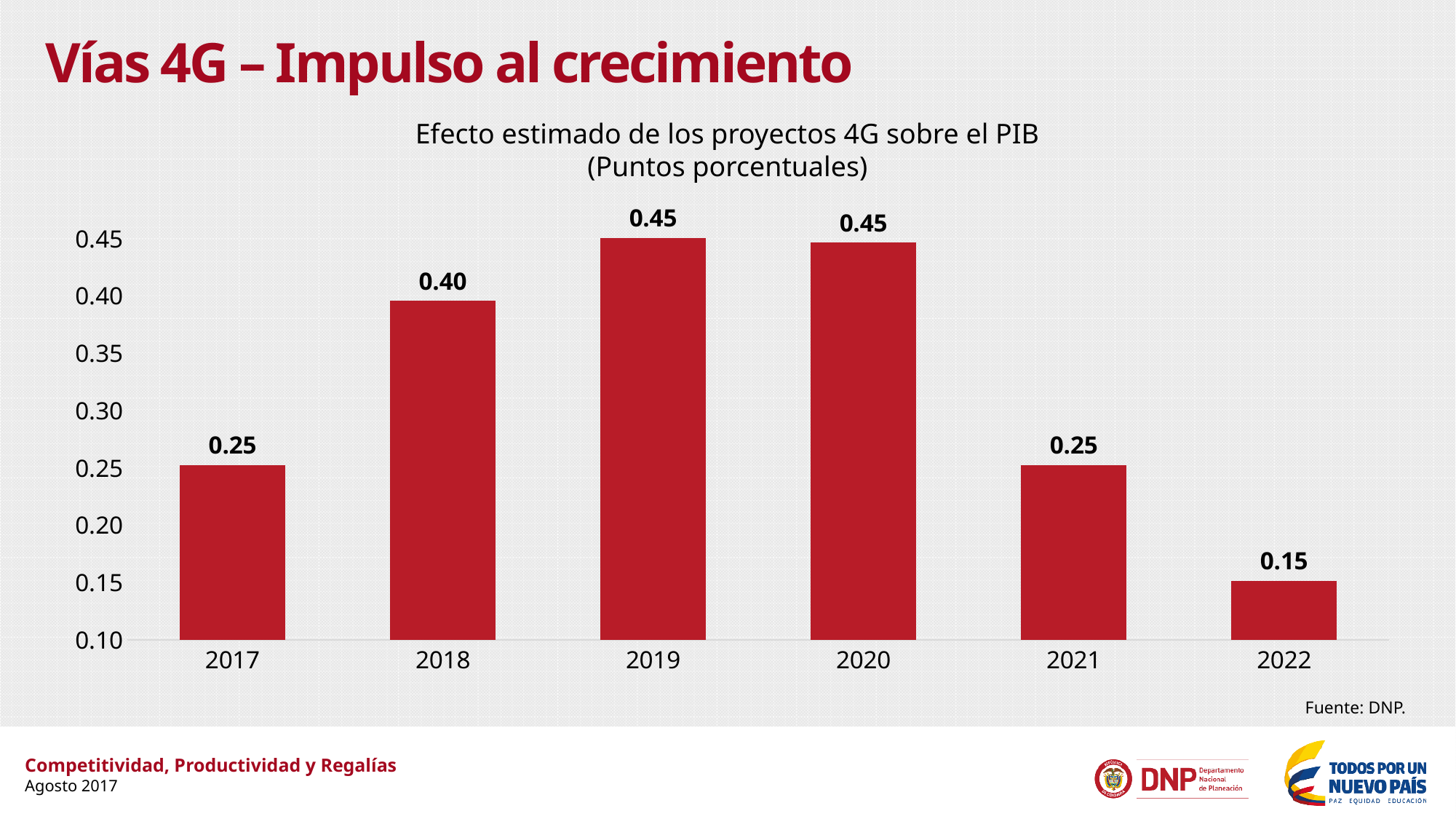
What is the difference between the values for 2019 and 2022? 0.30 Which is larger, the value for 2018 or the value for 2021? 2018 What is the title of the chart? Efecto estimado de los proyectos 4G sobre el PIB (Puntos porcentuales) What is the value shown for 2022? 0.15 Which years share the highest value in the chart? 2019 and 2020 Which year has the lowest value in the chart? 2022 What kind of chart is shown on the slide? Bar chart What is the value shown for 2021? 0.25 Do the values rise or fall from 2020 to 2022? Fall How many years are shown on the x axis of the chart? 6 What is the estimated effect of the 4G projects on GDP in 2018? 0.40 What is the difference between the values for 2018 and 2017? 0.15